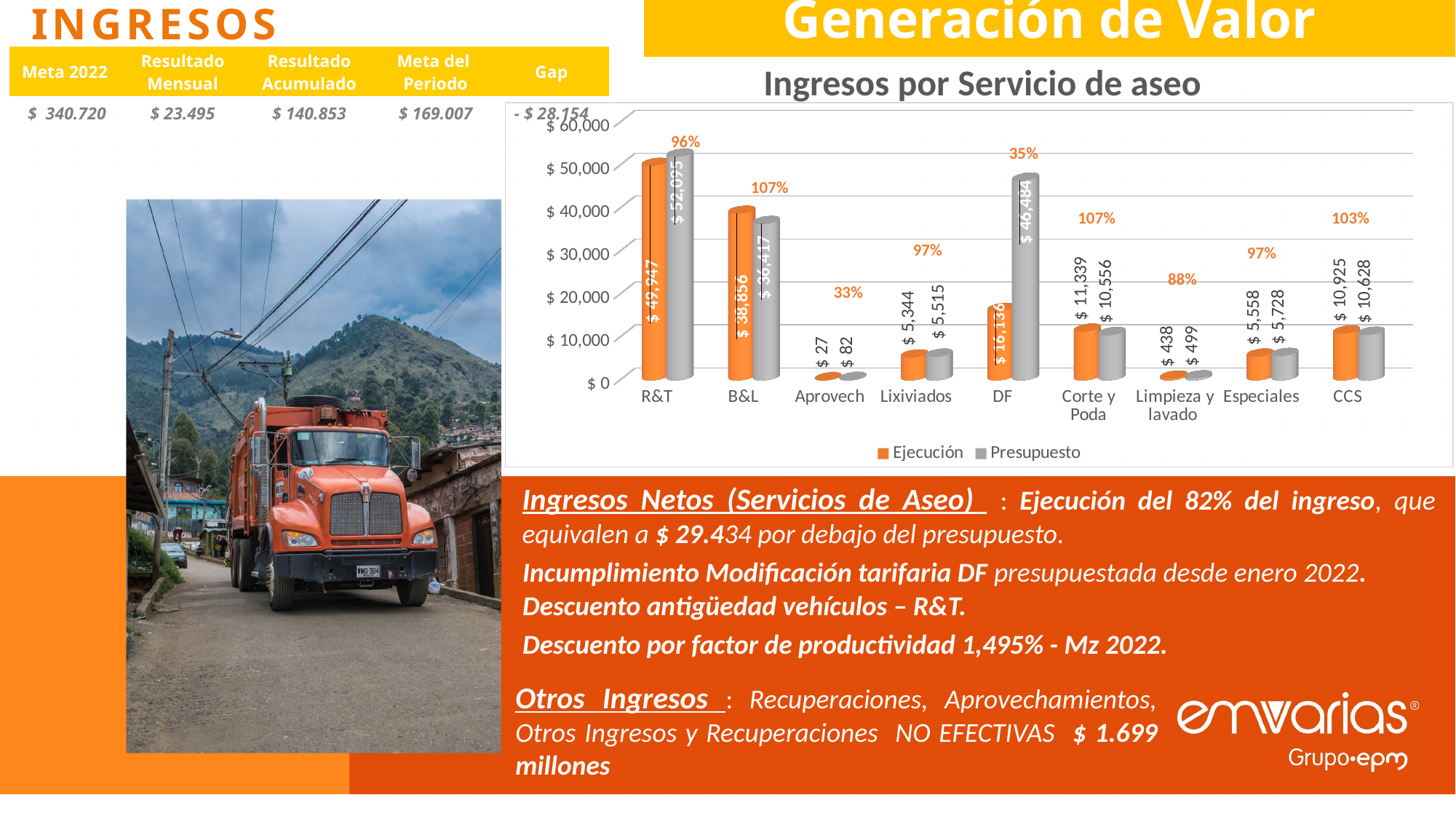
In the 'Ingresos por Servicio de aseo' chart, what is the Presupuesto value for DF? $ 46,484 In the 'Ingresos por Servicio de aseo' chart, what percentage label is shown above the DF bars? 35% In the 'Ingresos por Servicio de aseo' chart, which category has the highest Presupuesto value? R&T In the 'Ingresos por Servicio de aseo' chart, what is the Presupuesto value for R&T? $ 52,095 How many service categories are shown on the x axis of the 'Ingresos por Servicio de aseo' chart? 9 In the 'Ingresos por Servicio de aseo' chart, by how much does the Ejecución value for Corte y Poda exceed its Presupuesto value? $ 783 In the 'Ingresos por Servicio de aseo' chart, which is larger for B&L: Ejecución or Presupuesto? Ejecución In the 'Ingresos por Servicio de aseo' chart, what is the Ejecución value for Corte y Poda? $ 11,339 In the 'Ingresos por Servicio de aseo' chart, is the Presupuesto value for DF greater or less than $ 40,000? greater What kind of chart is 'Ingresos por Servicio de aseo'? bar chart In the 'Ingresos por Servicio de aseo' chart, which category has the lowest Ejecución value? Aprovech How many series does the legend of the 'Ingresos por Servicio de aseo' chart list? 2